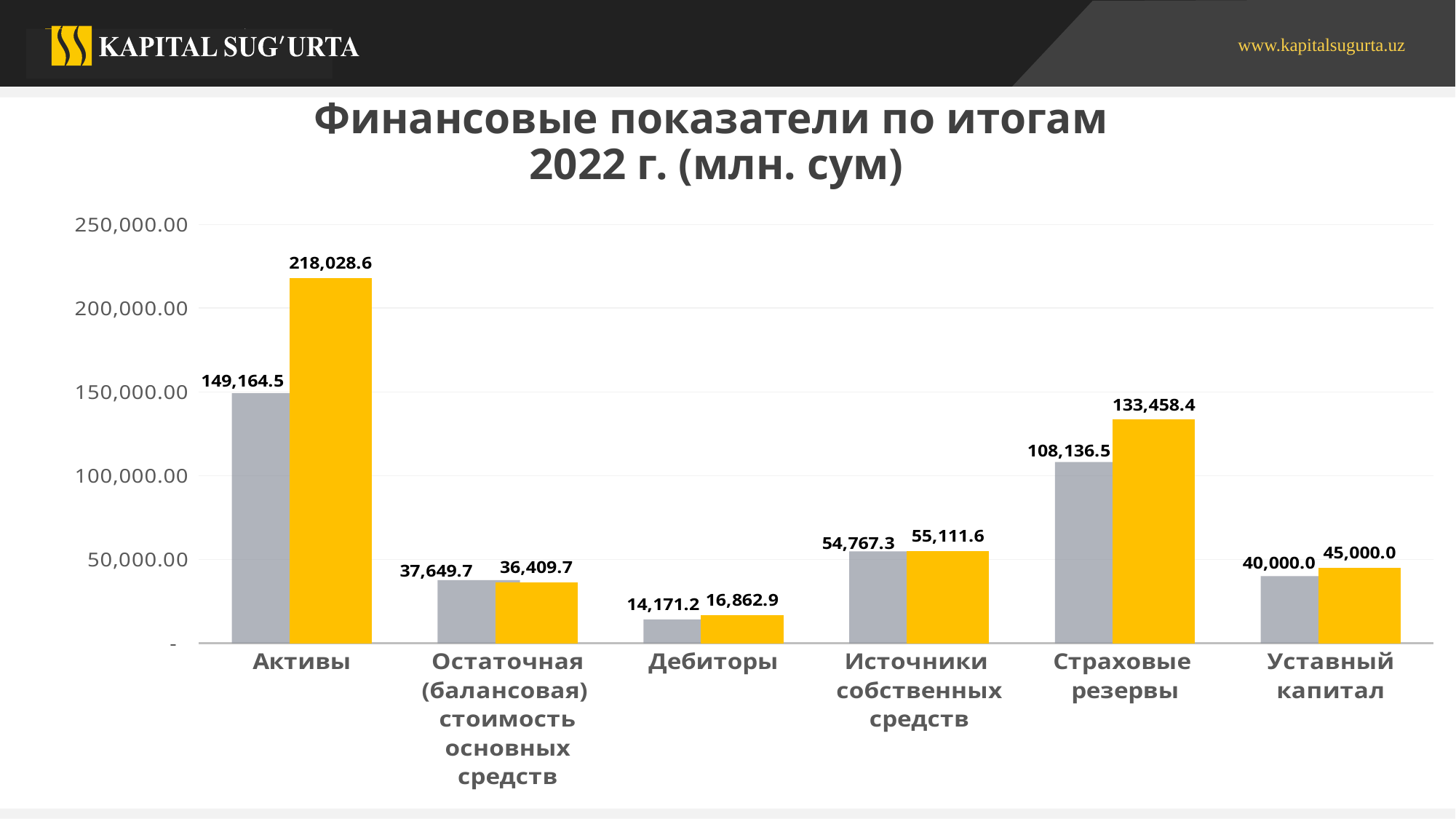
What is the value of the yellow bar for Дебиторы? 16,862.9 What is the difference between the yellow and grey bars for Активы? 68,864.1 What kind of chart is shown on the slide? bar chart How many categories are shown on the x axis? 6 Which category has the lowest grey bar? Дебиторы Which category has the highest yellow bar? Активы What is the value of the grey bar for Уставный капитал? 40,000.0 What is the value of the yellow bar for Активы? 218,028.6 What is the title of the chart? Финансовые показатели по итогам 2022 г. (млн. сум) What is the value of the grey bar for Страховые резервы? 108,136.5 For Остаточная (балансовая) стоимость основных средств, which bar is larger, the grey or the yellow? grey What is the difference between the yellow and grey bars for Уставный капитал? 5,000.0